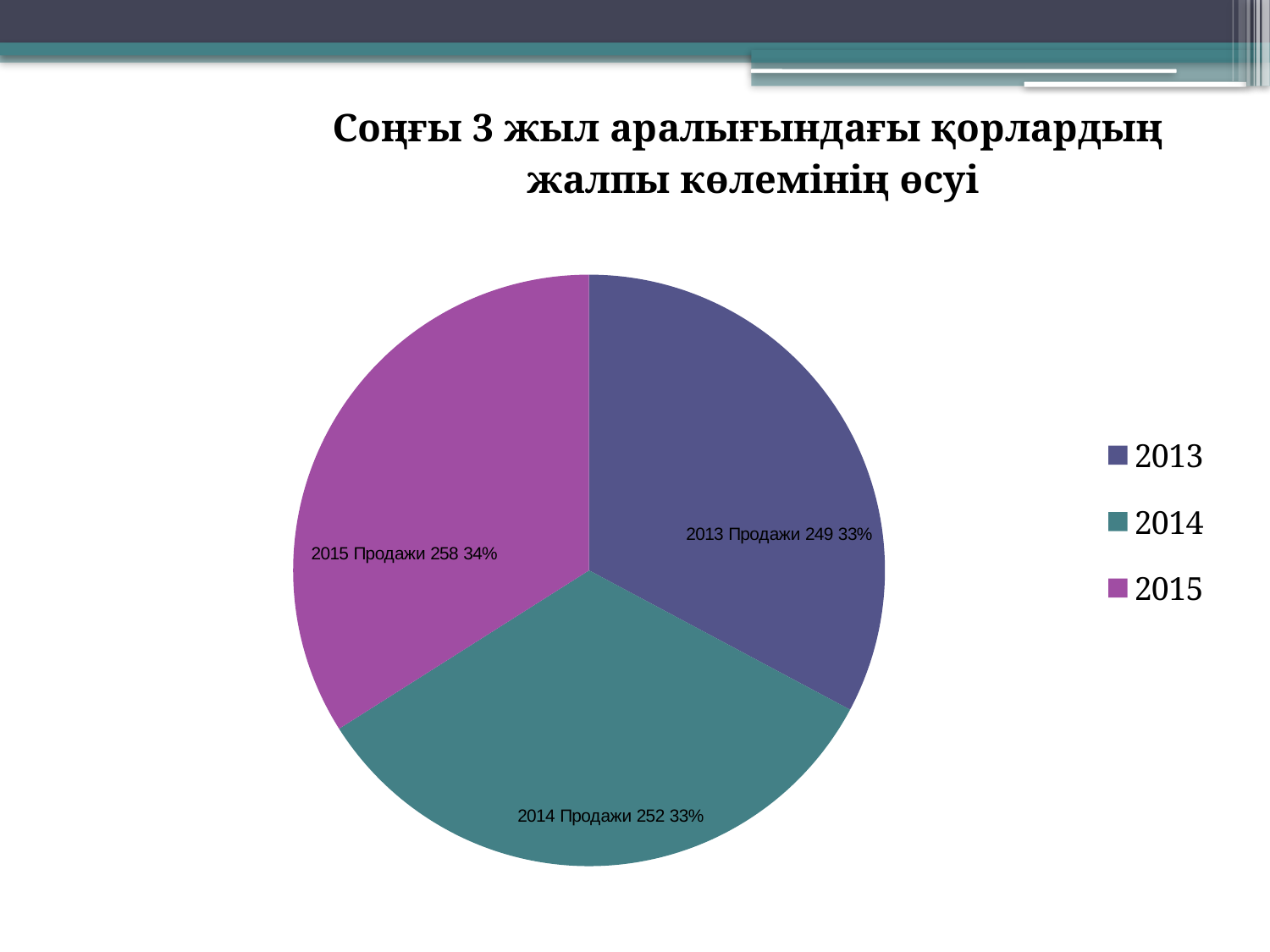
How many slices does the pie chart have? 3 What is the value for 2014 Продажи? 252 What is the difference between the values for 2015 and 2013? 9 What is the value for 2015 Продажи? 258 Which colour is used for the 2014 slice? teal What share of the pie does the 2013 slice represent? 33% Which year has the largest value? 2015 Which is larger, the value for 2014 or the value for 2013? 2014 What kind of chart is shown on the slide? pie chart Which year has the smallest value? 2013 What is the value for 2013 Продажи? 249 What share of the pie does the 2015 slice represent? 34%